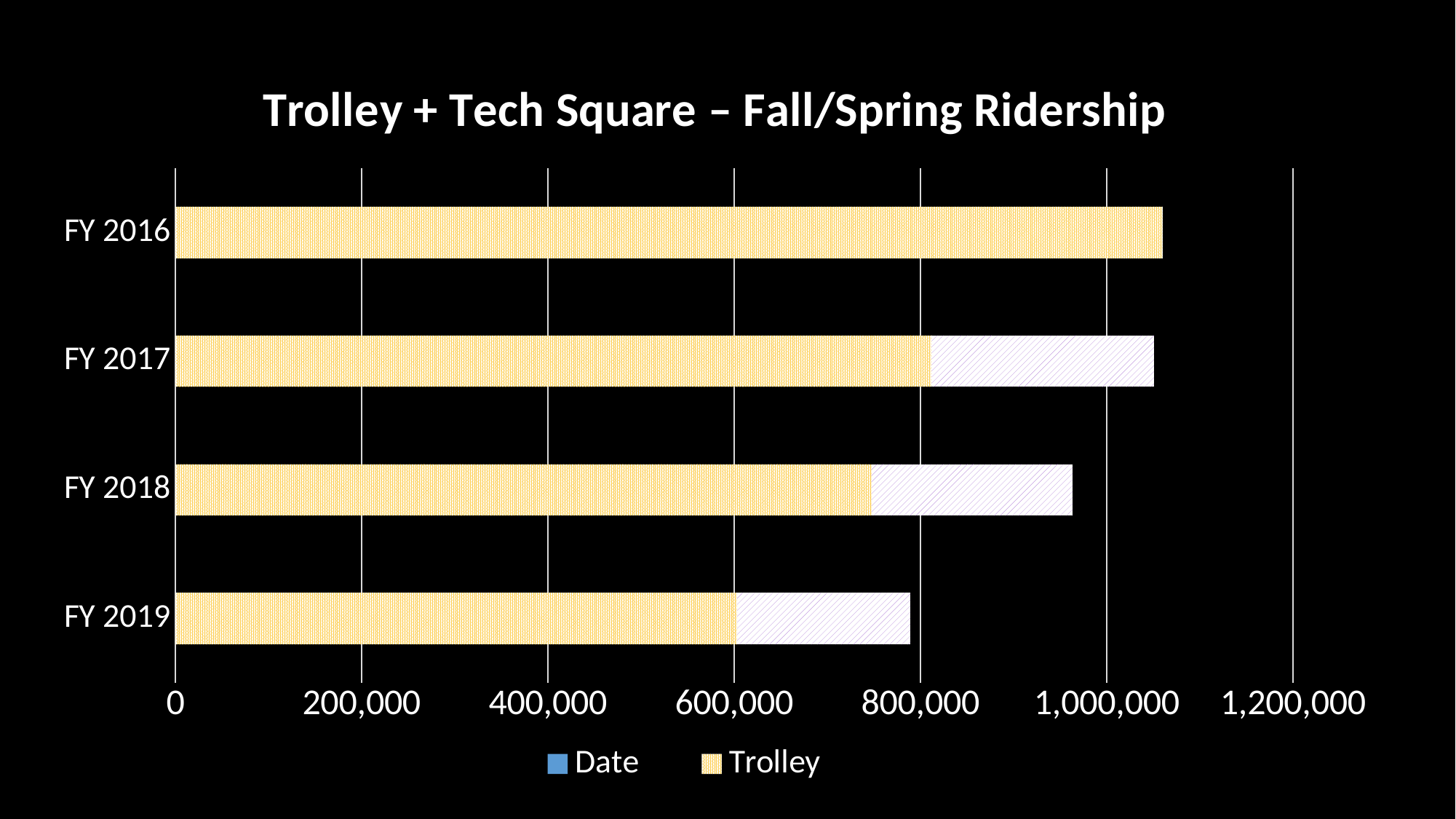
How many series does the legend list? 2 Is the total bar for FY 2016 greater or less than 1,000,000? greater Do the total ridership values rise or fall from FY 2016 to FY 2019? fall Is the total bar for FY 2018 greater or less than 1,000,000? less How many fiscal years are shown on the chart? 4 Is the total bar for FY 2018 greater or less than 800,000? greater Which series are listed in the legend? Date and Trolley Which has the larger total ridership, FY 2018 or FY 2019? FY 2018 What kind of chart is shown on the slide? bar chart Which fiscal year has the lowest total ridership? FY 2019 What is the title of the chart? Trolley + Tech Square – Fall/Spring Ridership